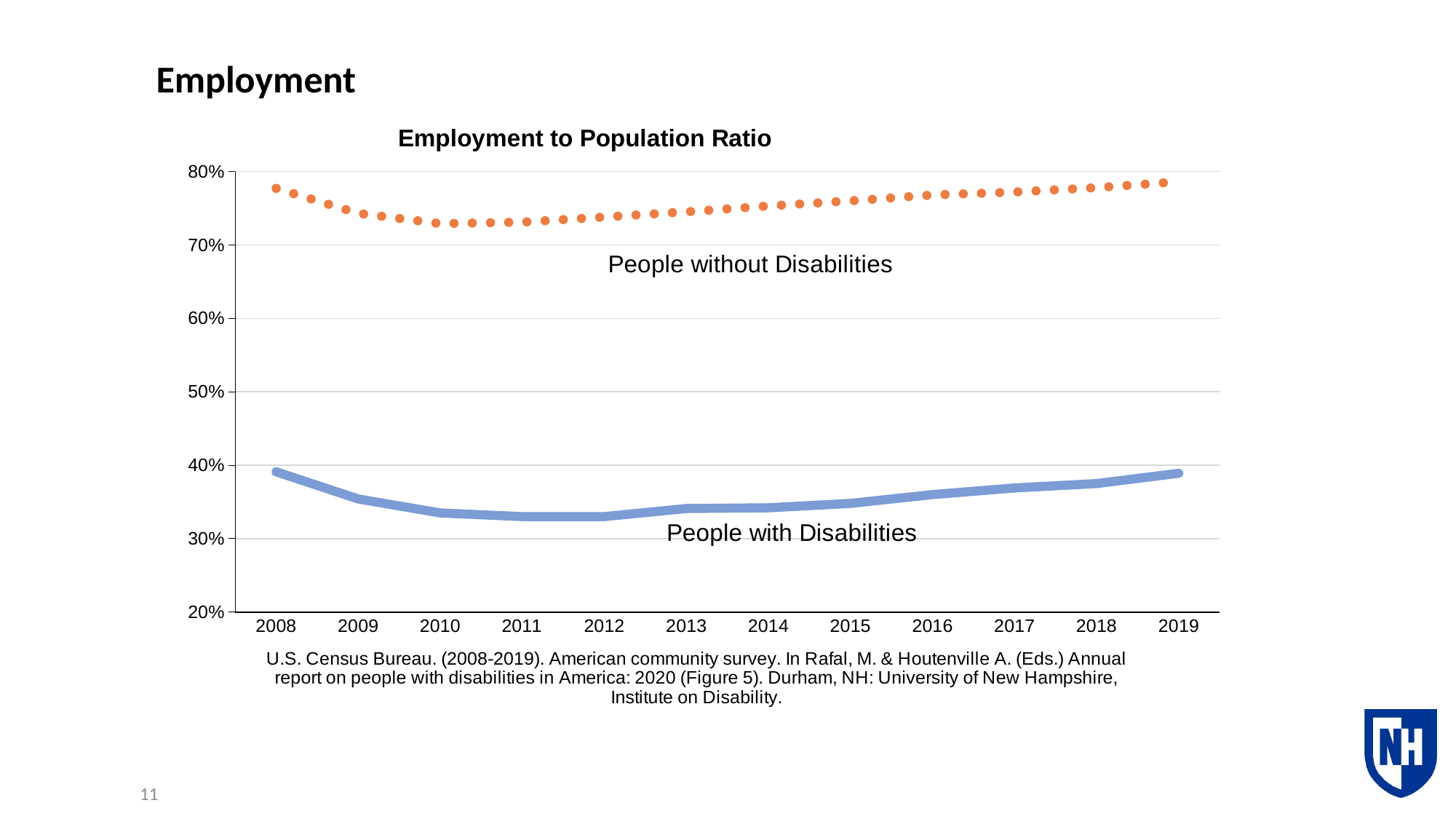
Is the value for People without Disabilities in 2019 greater or less than 80%? less Is the value for People with Disabilities in 2011 greater or less than 30%? greater What kind of chart is shown on the slide? line chart Does the People with Disabilities line rise or fall from 2012 to 2019? rise Does the People without Disabilities line rise or fall from 2008 to 2010? fall Is the value for People with Disabilities in 2008 greater or less than 40%? less Which series has the higher values throughout the chart, People with Disabilities or People without Disabilities? People without Disabilities For People with Disabilities, which year has the larger value, 2008 or 2011? 2008 How many series are plotted on the chart? 2 How many years are shown on the x axis of the chart? 12 What is the title of the chart? Employment to Population Ratio